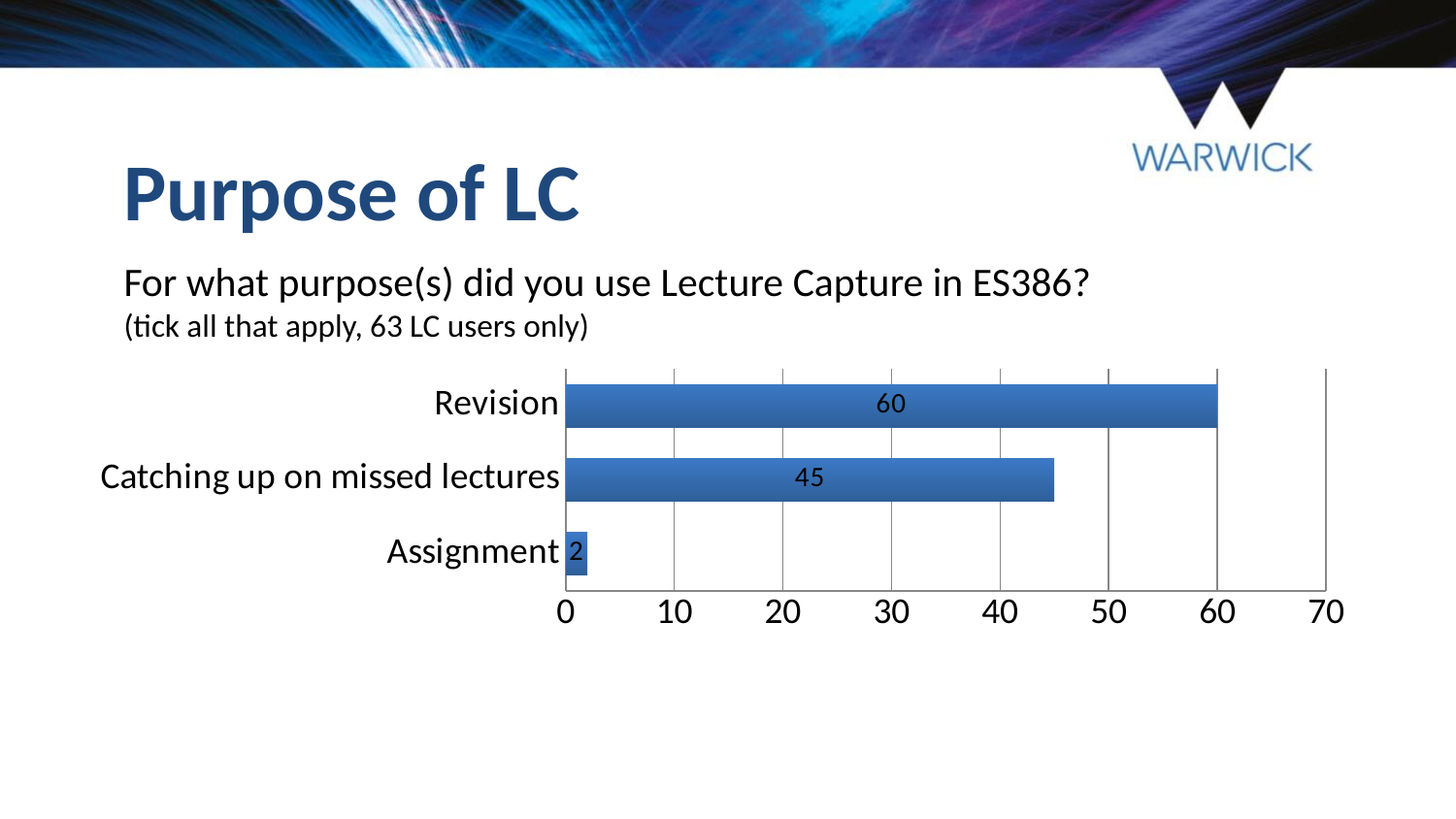
Which purpose has the lowest value? Assignment What is the value for Catching up on missed lectures? 45 Which is larger, the value for Revision or the value for Assignment? Revision What is the value for Assignment? 2 What is the difference between the values for Revision and Catching up on missed lectures? 15 Is the value for Catching up on missed lectures greater or less than 40? greater What kind of chart is shown on the slide? bar chart How many categories are shown in the chart? 3 Which purpose has the highest value? Revision What is the highest value shown on the horizontal axis? 70 What is the difference between the values for Catching up on missed lectures and Assignment? 43 What is the value for Revision? 60